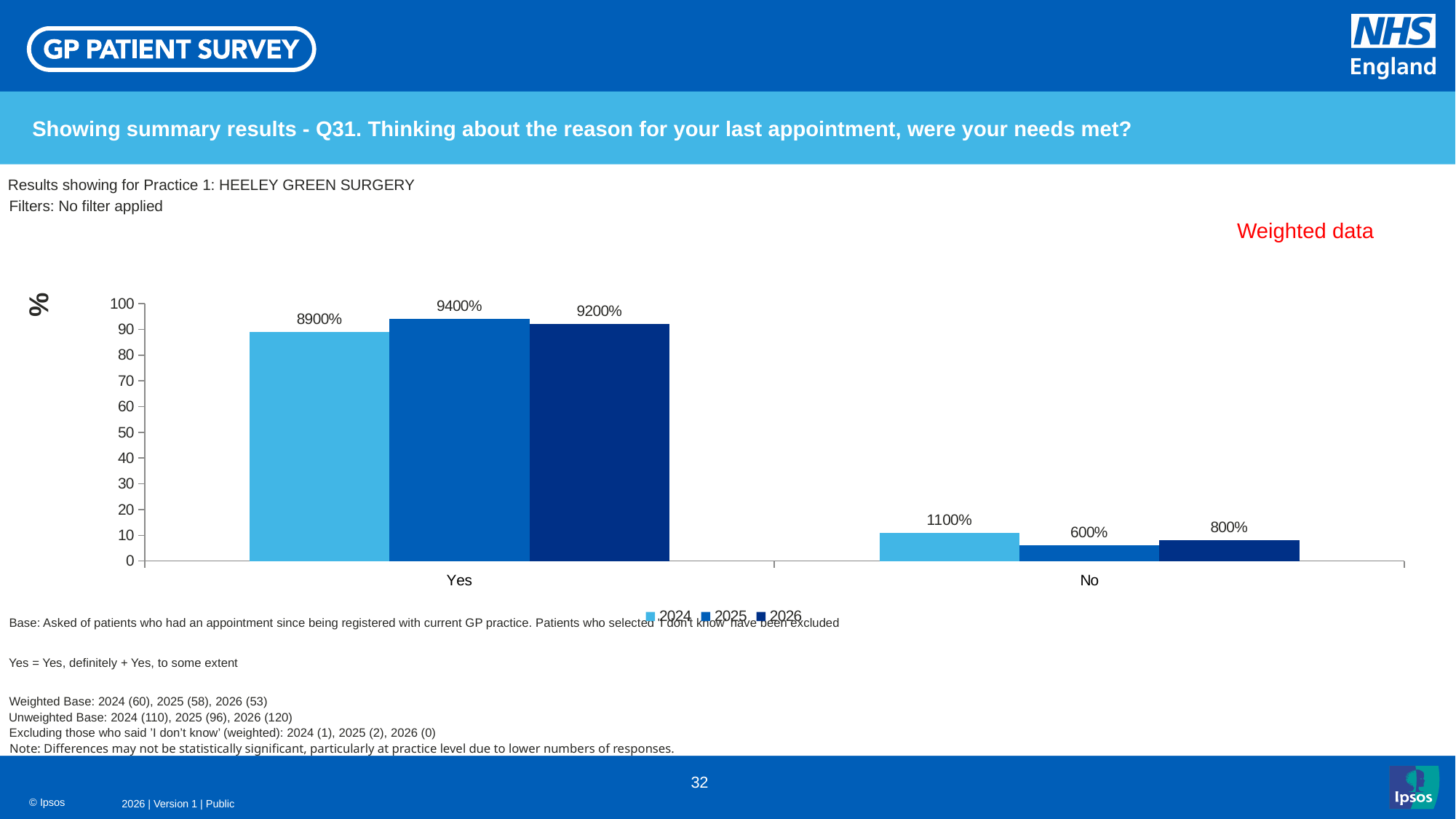
What is the data label shown for 2026 in the Yes category? 9200% What is the data label shown for 2025 in the No category? 600% What kind of chart is shown on the slide? Bar chart What are the series names listed in the legend? 2024, 2025, 2026 How many series does the legend list? 3 How many categories are shown on the x axis? 2 Which year has the highest bar in the Yes category? 2025 Which year has the lowest bar in the No category? 2025 Is the 2024 bar in the Yes category greater or less than 80 on the axis? greater Which is larger in the Yes category, the 2024 bar or the 2026 bar? 2026 What is the data label shown for 2025 in the Yes category? 9400% What is the data label shown for 2024 in the No category? 1100%